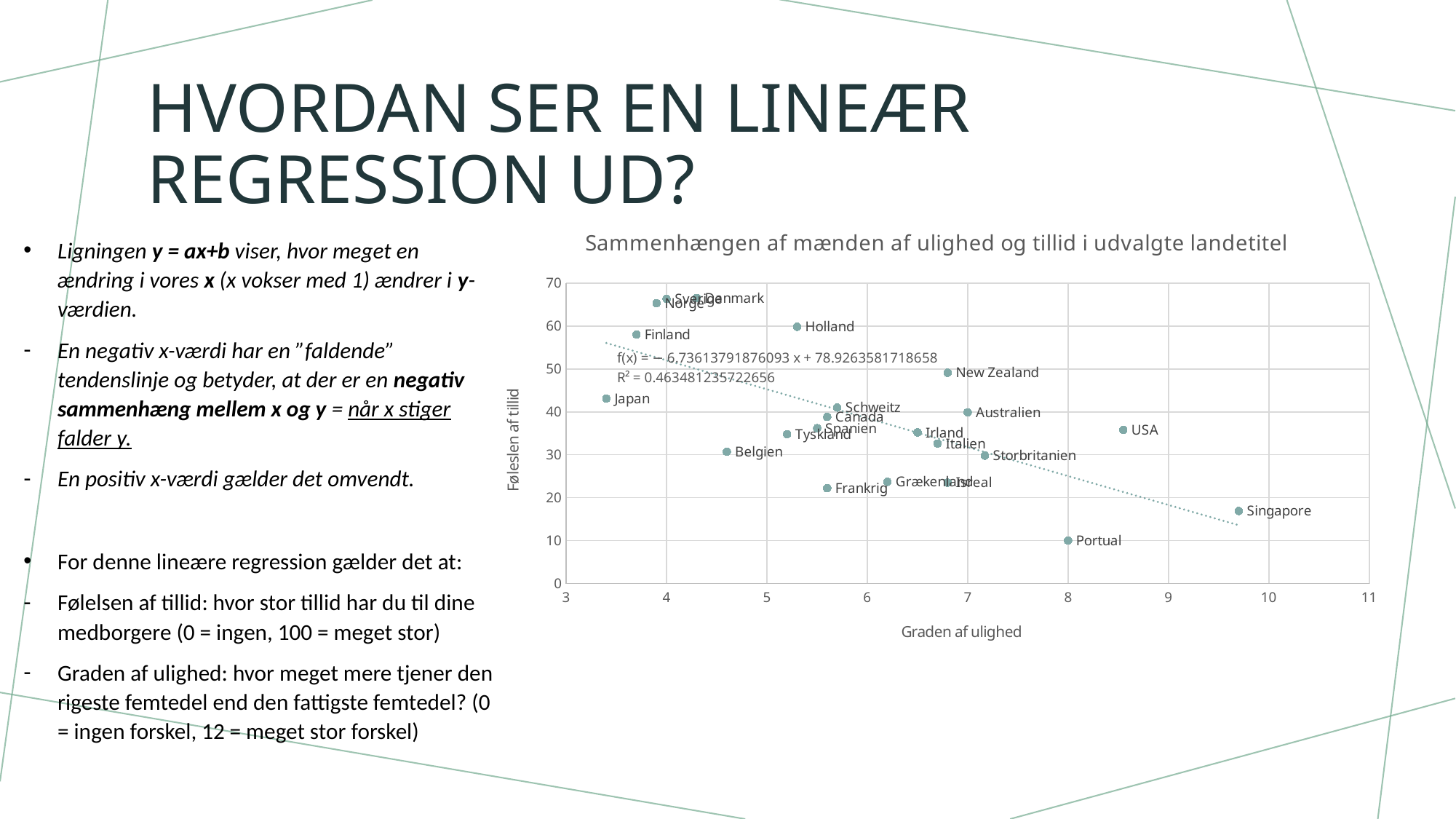
Which country has the highest value on the Graden af ulighed axis? Singapore Is the Graden af ulighed value for USA greater or less than 8? greater Which has a higher Føleslen af tillid value, Japan or USA? Japan Is the Graden af ulighed value for Singapore greater or less than 9? greater Does the trendline rise or fall as Graden af ulighed increases? Falls Is the Føleslen af tillid value for Frankrig greater or less than 30? less Which country has the lowest value on the Føleslen af tillid axis? Portual What is the label of the x axis of the chart? Graden af ulighed What kind of chart is shown on the slide? Scatter chart What is the title of the chart? Sammenhængen af mænden af ulighed og tillid i udvalgte landetitel Which country has the lowest value on the Graden af ulighed axis? Japan